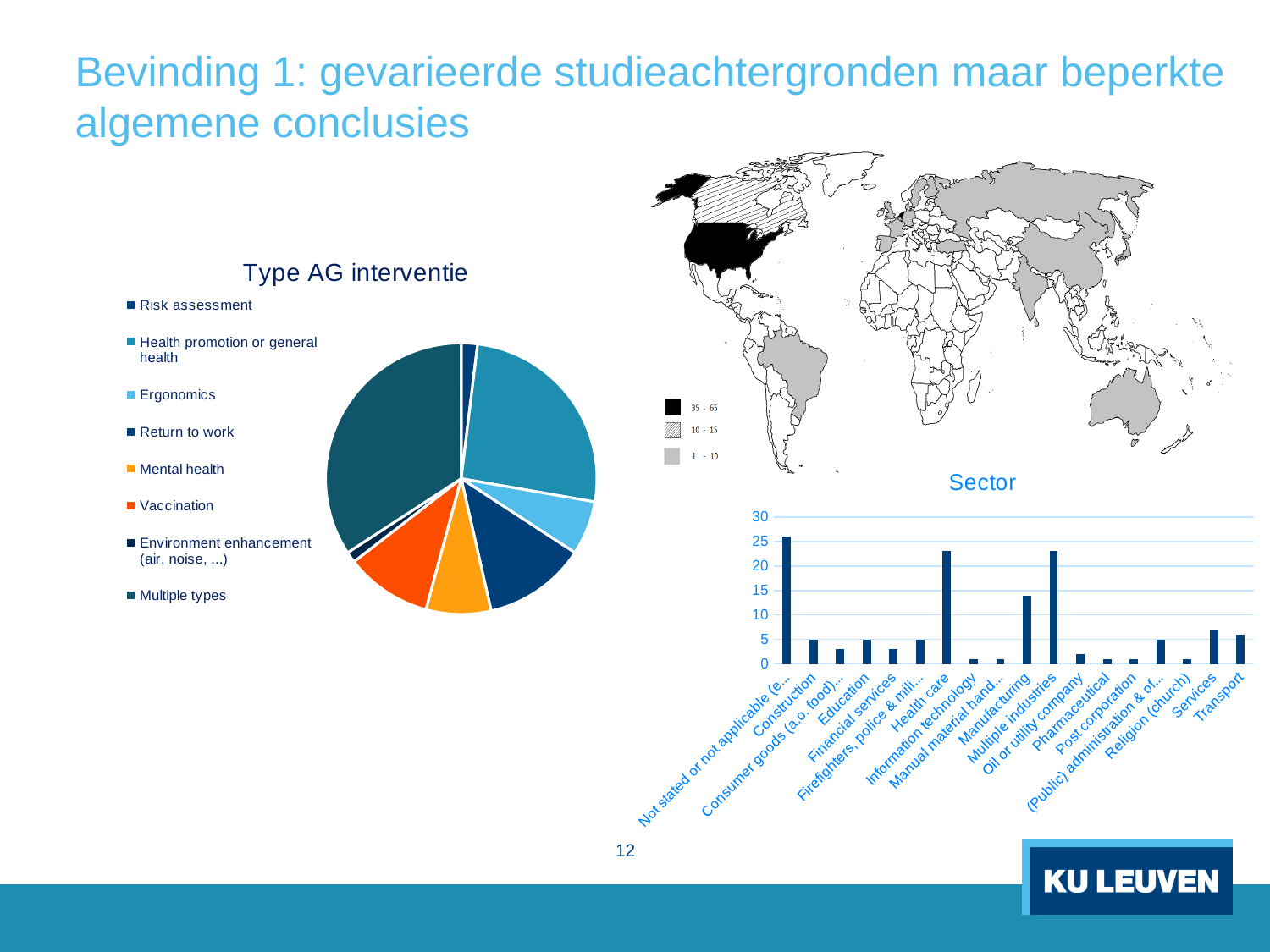
How many sector categories are shown on the x axis of the 'Sector' bar chart? 18 In the 'Sector' bar chart, is the value for Manufacturing greater or less than 10? greater In the 'Sector' bar chart, is the value for Oil or utility company greater or less than 5? less In the 'Sector' bar chart, is the value for Health care greater or less than 20? greater In the 'Sector' bar chart, which is larger: Construction or Health care? Health care In the 'Sector' bar chart, which is larger: Manufacturing or Services? Manufacturing In the 'Sector' bar chart, which category has the highest bar? Not stated or not applicable What kind of chart is the 'Type AG interventie' chart? pie chart What kind of chart is the 'Sector' chart? bar chart How many entries does the legend of the 'Type AG interventie' pie chart list? 8 In the 'Type AG interventie' pie chart, which category has the largest slice? Multiple types